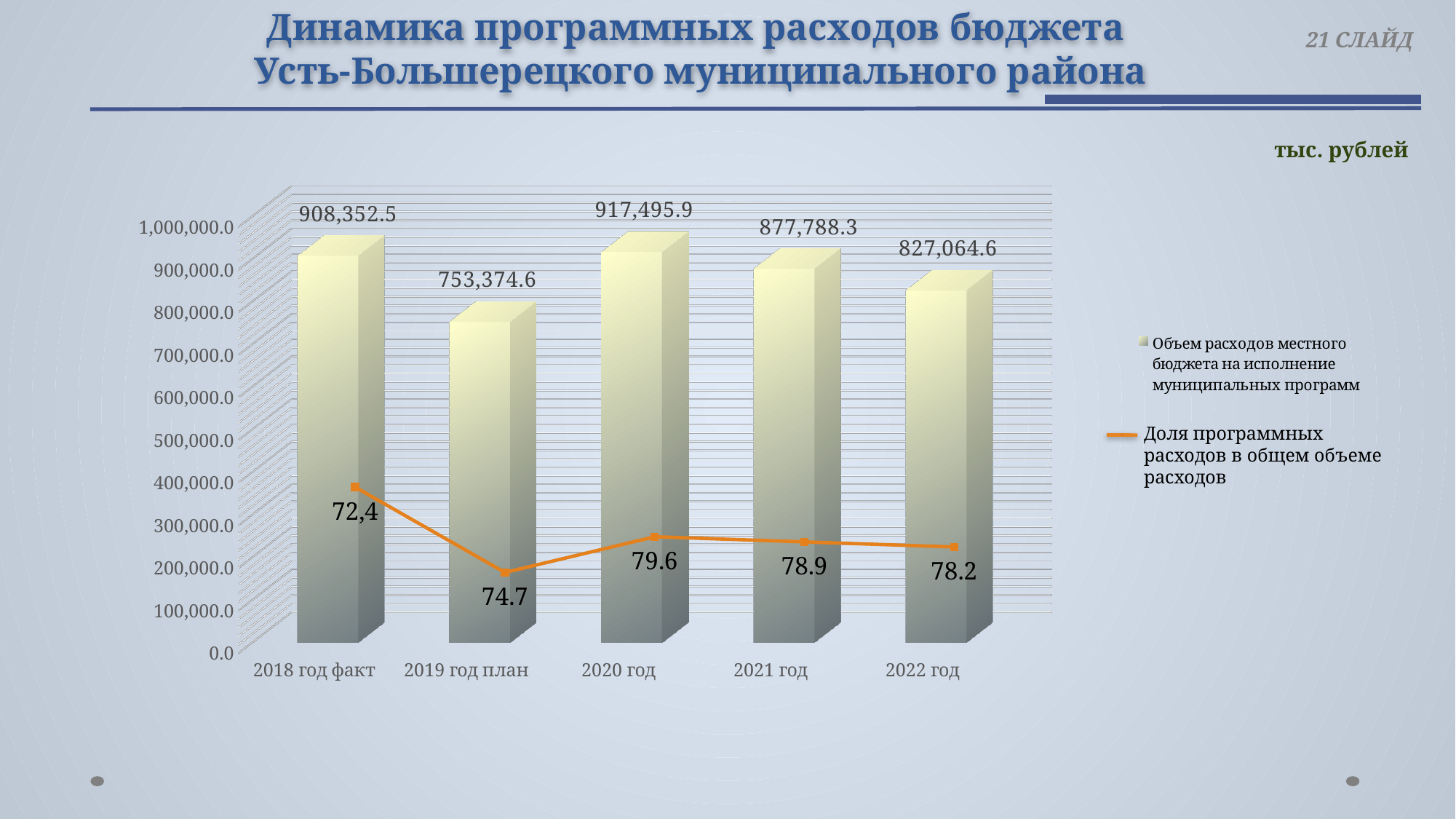
What is the difference between the bar values for 2020 год and 2018 год факт? 9,143.4 What is the value of the line series (Доля программных расходов в общем объеме расходов) for 2020 год? 79.6 What is the value of the bar for 2018 год факт? 908,352.5 What is the difference between the bar values for 2021 год and 2022 год? 50,723.7 What is the value of the bar for 2019 год план? 753,374.6 Which category has the highest bar value? 2020 год What is the value of the line series for 2022 год? 78.2 How many series does the legend list? 2 How many categories are shown on the x axis? 5 Which category has the lowest bar value? 2019 год план Which is larger: the bar value for 2021 год or for 2022 год? 2021 год What kind of chart is shown on the slide? A bar chart combined with a line chart